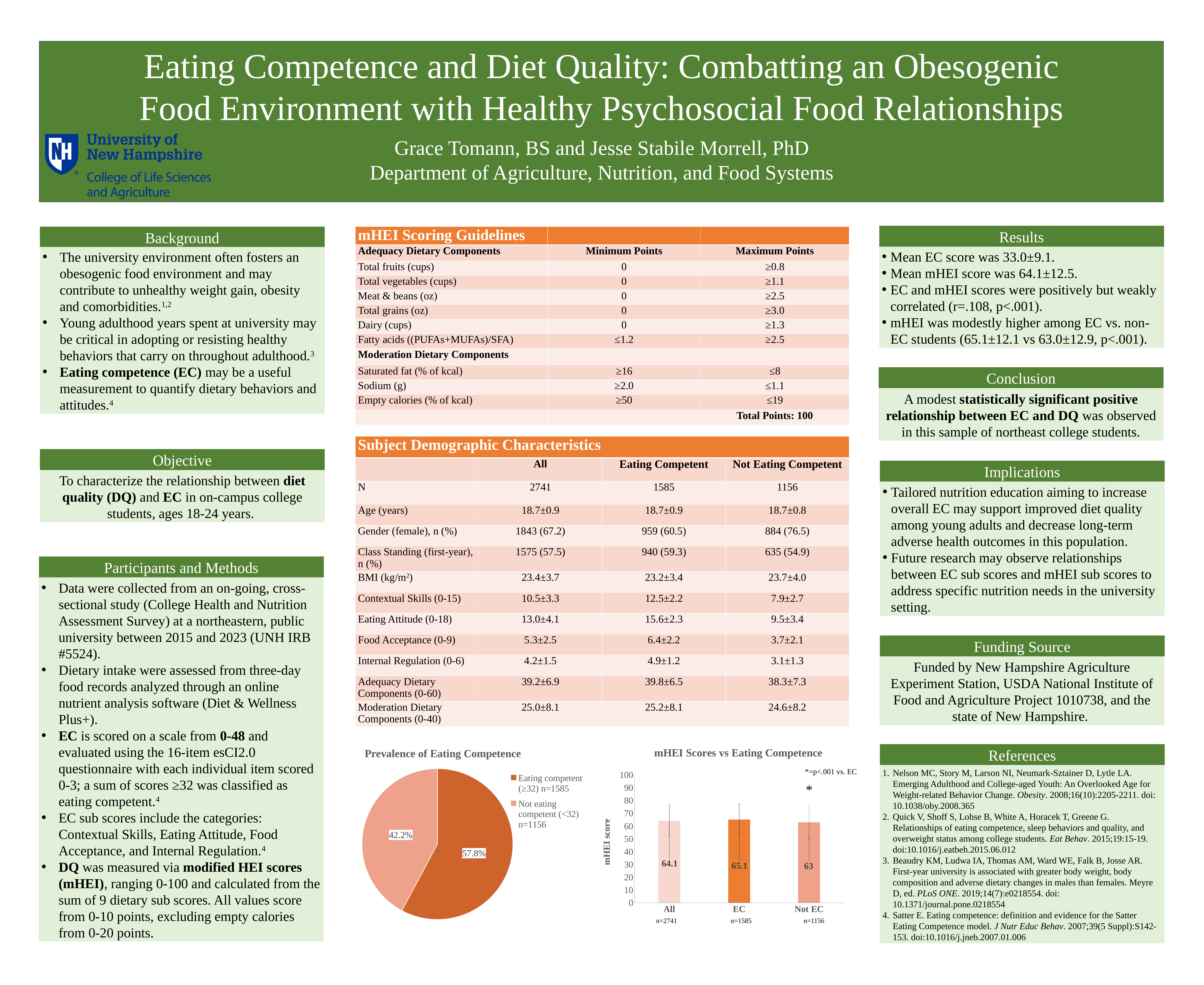
In the 'mHEI Scores vs Eating Competence' chart, what is the mHEI score for the 'Not EC' group? 63 What kind of chart is 'mHEI Scores vs Eating Competence'? Bar chart In the 'mHEI Scores vs Eating Competence' chart, what is the mHEI score for the 'EC' group? 65.1 How many slices does the 'Prevalence of Eating Competence' pie chart have? 2 In the 'mHEI Scores vs Eating Competence' chart, which group has the highest mHEI score? EC In the 'mHEI Scores vs Eating Competence' chart, what is the difference between the mHEI scores of the 'EC' and 'Not EC' groups? 2.1 In the 'Prevalence of Eating Competence' chart, what share of the pie is labelled 'Eating competent (≥32)'? 57.8% In the 'mHEI Scores vs Eating Competence' chart, what is the mHEI score for the 'All' group? 64.1 In the 'Prevalence of Eating Competence' chart, which slice is larger: 'Eating competent' or 'Not eating competent'? Eating competent What kind of chart is 'Prevalence of Eating Competence'? Pie chart In the 'Prevalence of Eating Competence' chart, what share of the pie is labelled 'Not eating competent (<32)'? 42.2% In the 'mHEI Scores vs Eating Competence' chart, how many groups are plotted on the x axis? 3